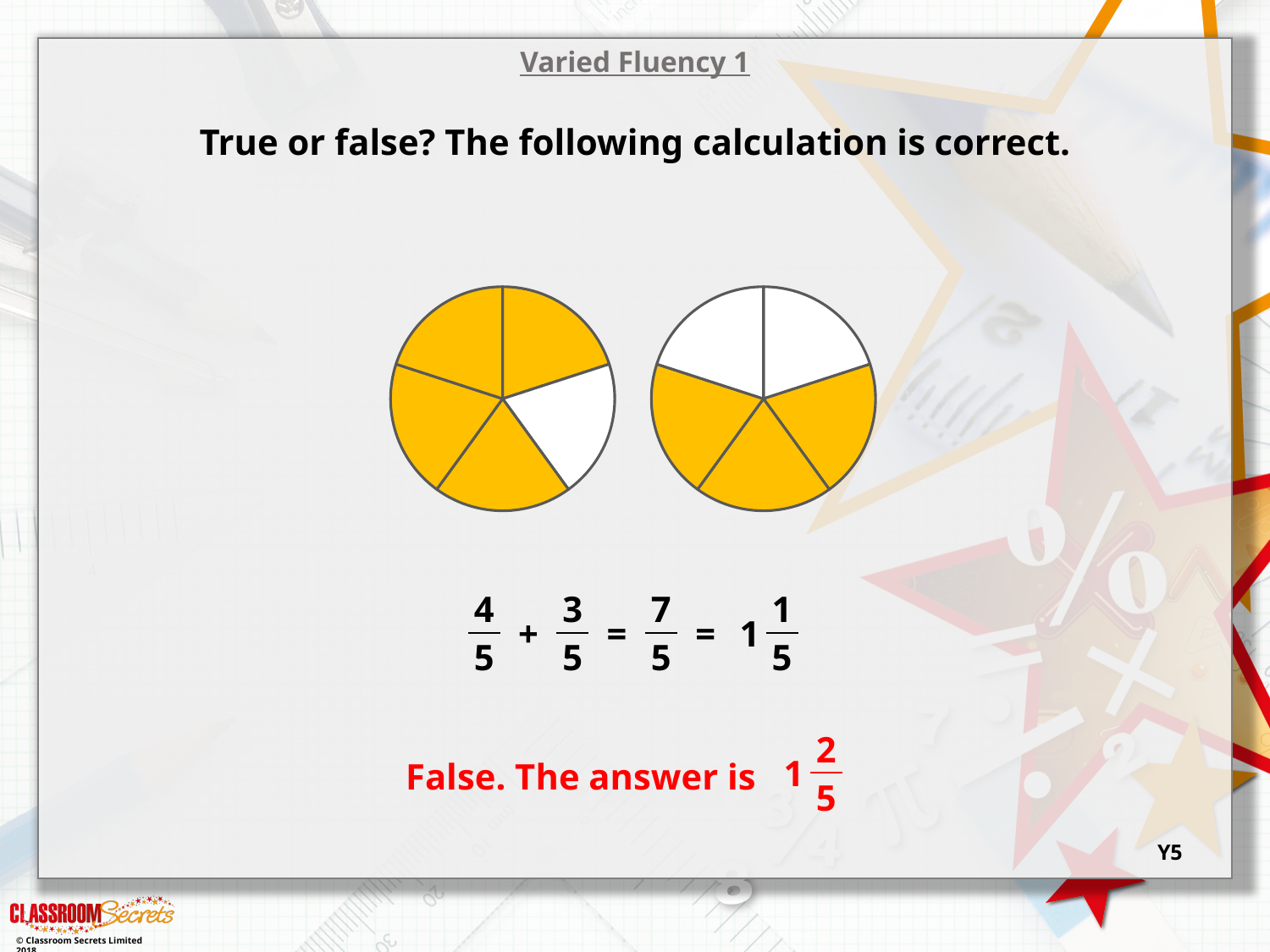
In the right circle, how many equal sections is the circle divided into? 5 In the left circle, how many equal sections is the circle divided into? 5 According to the slide, what is the correct answer to 4/5 + 3/5? 1 2/5 What kind of chart are the two circular diagrams on the slide? pie chart In the right circle, how many sections are shaded yellow? 3 What fraction of the right circle is shaded yellow? 3/5 What colour are the shaded sections of the circles? yellow What fraction of the left circle is shaded yellow? 4/5 Which circle has more shaded sections, the left or the right? left How many more sections are shaded in the left circle than in the right circle? 1